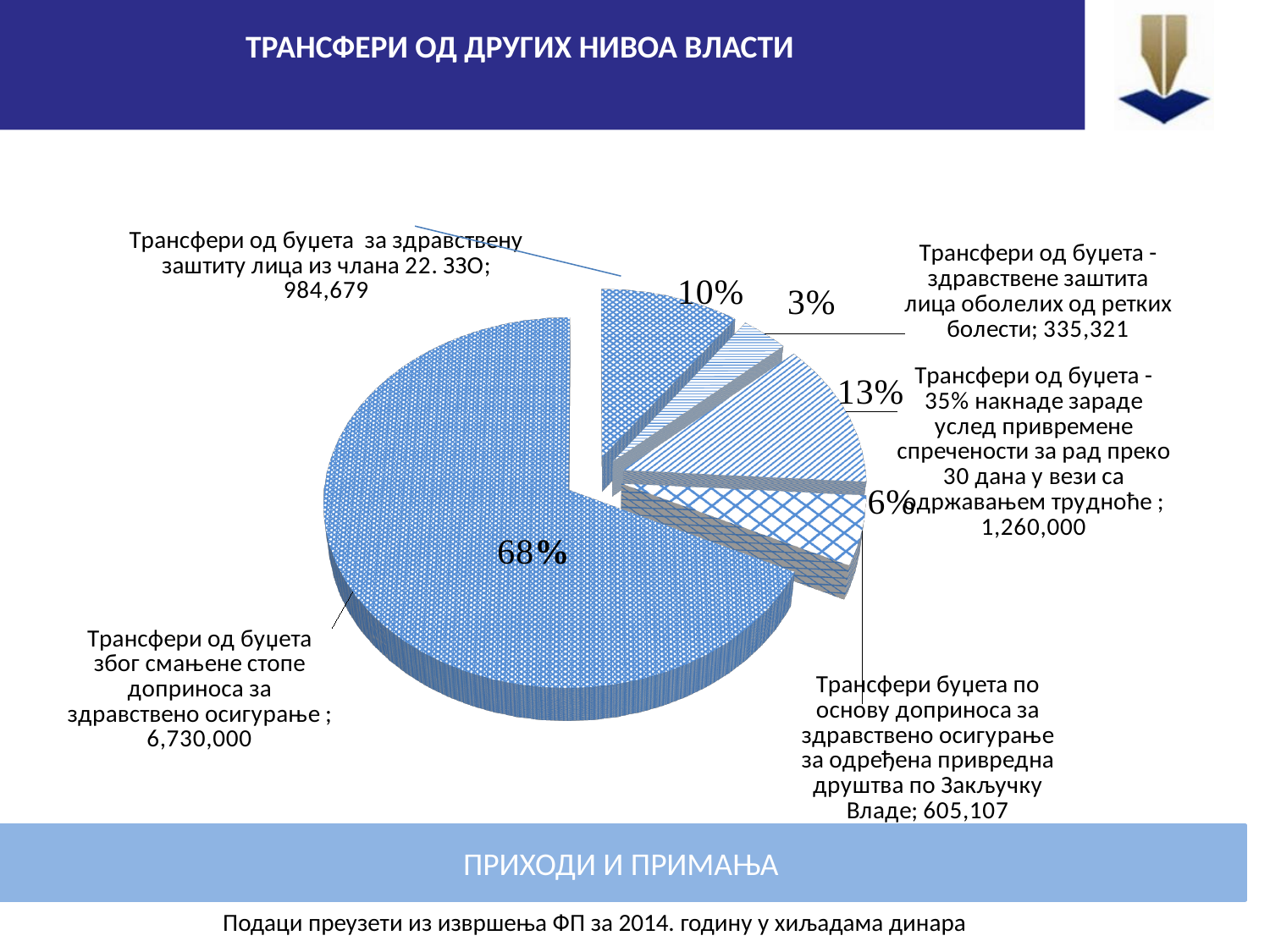
What type of chart is shown on the slide? pie chart What is the value for 'Трансфери од буџета за здравствену заштиту лица из члана 22. ЗЗО'? 984,679 Which category has the smallest slice of the pie? Трансфери од буџета - здравствене заштита лица оболелих од ретких болести What is the title of the chart on the slide? ТРАНСФЕРИ ОД ДРУГИХ НИВОА ВЛАСТИ What share of the pie does the slice for 'Трансфери од буџета - 35% накнаде зараде услед привремене спречености за рад преко 30 дана у вези са одржавањем трудноће' represent? 13% Which is larger: the value for 'Трансфери од буџета за здравствену заштиту лица из члана 22. ЗЗО' or the value for 'Трансфери буџета по основу доприноса за здравствено осигурање за одређена привредна друштва по Закључку Владе'? Трансфери од буџета за здравствену заштиту лица из члана 22. ЗЗО What is the difference between the value for 'Трансфери од буџета због смањене стопе доприноса за здравствено осигурање' and the value for 'Трансфери од буџета - 35% накнаде зараде услед привремене спречености за рад преко 30 дана у вези са одржавањем трудноће'? 5,470,000 What is the value for 'Трансфери од буџета - здравствене заштита лица оболелих од ретких болести'? 335,321 What is the value for 'Трансфери буџета по основу доприноса за здравствено осигурање за одређена привредна друштва по Закључку Владе'? 605,107 What is the value for 'Трансфери од буџета због смањене стопе доприноса за здравствено осигурање'? 6,730,000 How many slices does the pie chart have? 5 Which category has the largest slice of the pie? Трансфери од буџета због смањене стопе доприноса за здравствено осигурање